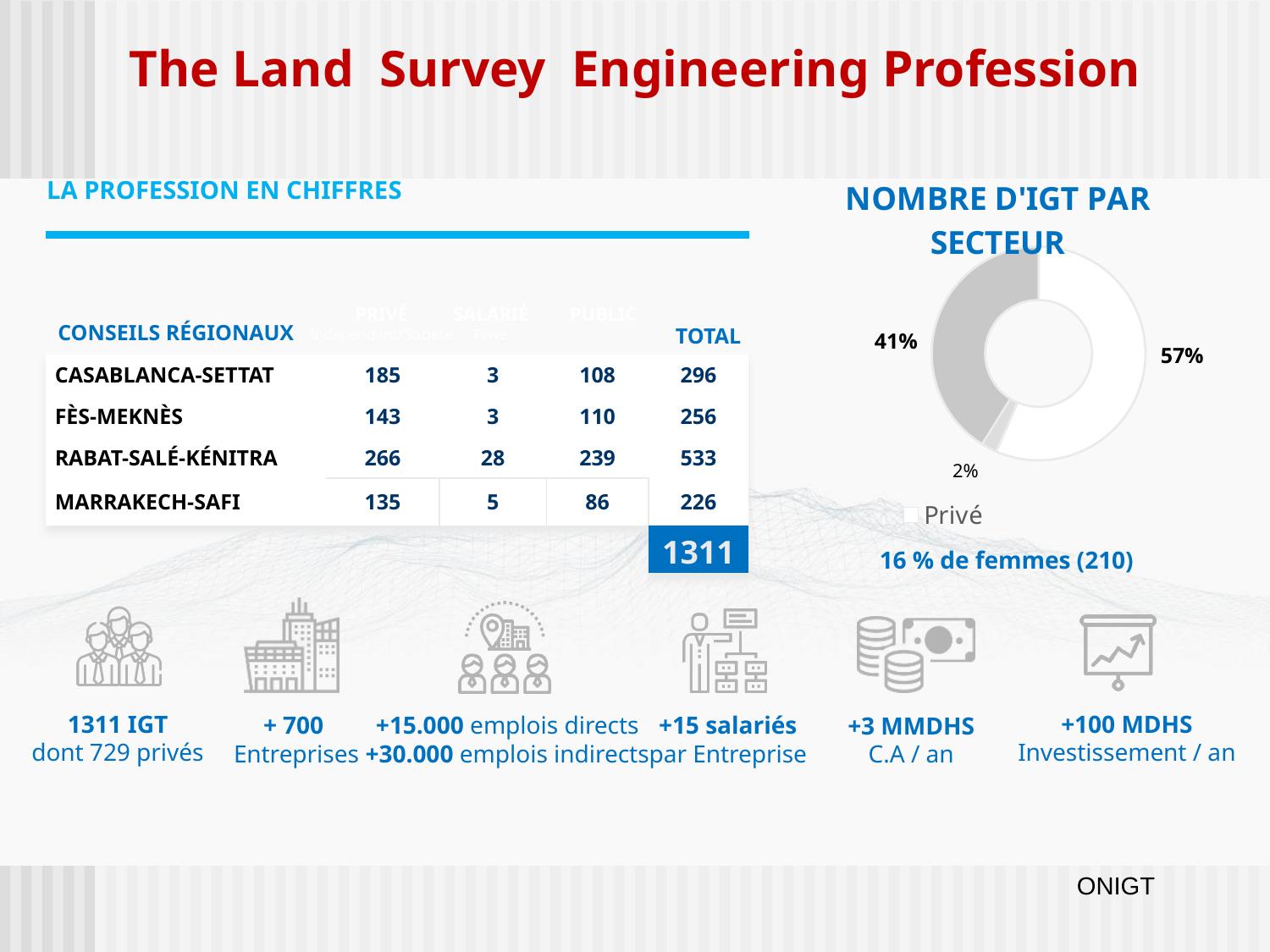
In the "NOMBRE D'IGT PAR SECTEUR" chart, what is the difference between the 41% slice and the 2% slice? 39% In the "NOMBRE D'IGT PAR SECTEUR" chart, what is the largest percentage shown? 57% What kind of chart is shown under the title "NOMBRE D'IGT PAR SECTEUR"? Doughnut chart Which legend entry is readable below the "NOMBRE D'IGT PAR SECTEUR" chart? Privé In the "NOMBRE D'IGT PAR SECTEUR" chart, what percentage is shown on the left side of the doughnut? 41% In the "NOMBRE D'IGT PAR SECTEUR" chart, which is larger, the slice labelled 57% or the slice labelled 41%? 57% What is the title of the doughnut chart on the slide? NOMBRE D'IGT PAR SECTEUR In the "NOMBRE D'IGT PAR SECTEUR" chart, what percentage is shown on the right side of the doughnut? 57% In the "NOMBRE D'IGT PAR SECTEUR" chart, what is the difference between the largest slice (57%) and the second largest slice (41%)? 16% How many slices does the "NOMBRE D'IGT PAR SECTEUR" chart have? 3 In the "NOMBRE D'IGT PAR SECTEUR" chart, what is the smallest percentage shown? 2%